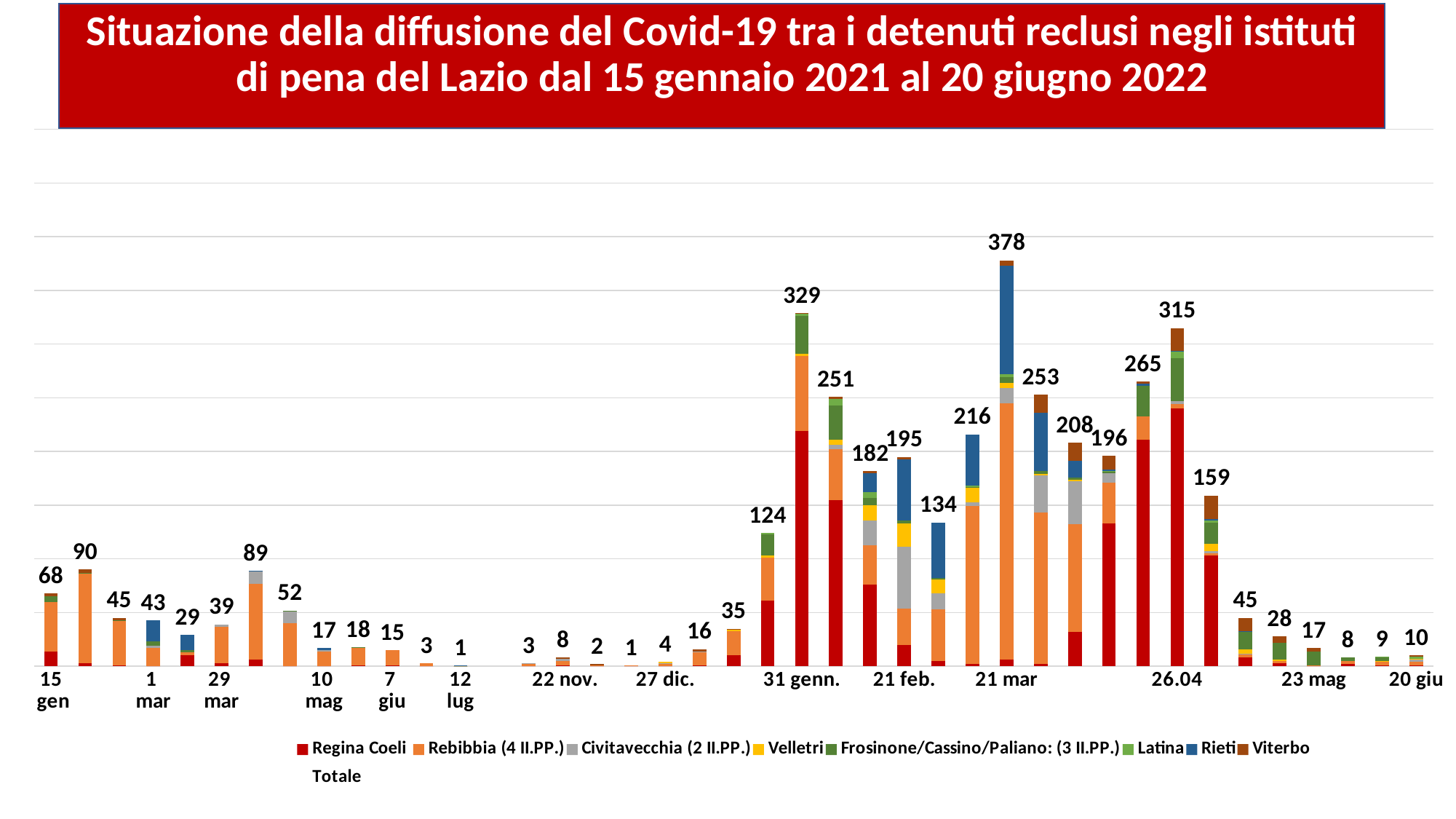
What is the total value shown for 21 mar? 378 How many entries does the legend list? 9 Which is larger, the total for 26.04 or the total for 31 genn.? 31 genn. Which series is shown in red in the legend? Regina Coeli What is the total value shown for 20 giu? 10 Do the totals rise or fall from 26.04 to 20 giu? Fall What kind of chart is shown on the slide? Stacked bar chart What is the difference between the totals for 15 gen and 20 giu? 58 What is the total value shown for 15 gen? 68 Which date has the highest total? 21 mar What is the difference between the totals for 21 mar and 31 genn.? 49 What is the total value shown for 31 genn.? 329